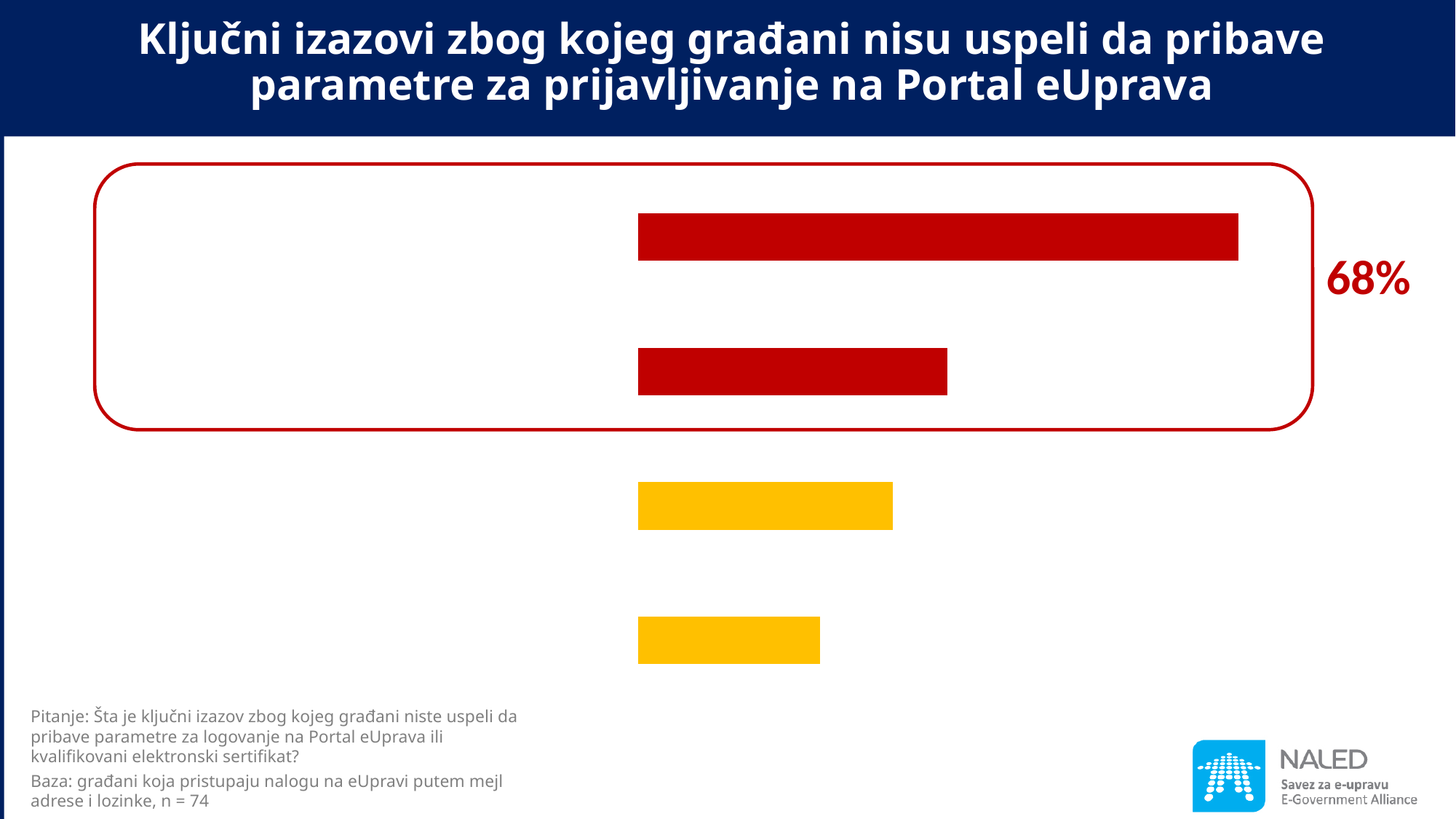
Which is longer, the second bar from the top or the third bar from the top? the second bar from the top How many bars are coloured red? 2 Which bar is the shortest: the top, second, third or bottom bar? the bottom bar How many bars does the chart contain? 4 What kind of chart is shown on the slide? bar chart Do the bar lengths increase or decrease from the top bar to the bottom bar? decrease What colour are the bottom two bars? yellow Which bar is the longest: the top, second, third or bottom bar? the top bar What is the sample size (n) stated in the base note at the bottom of the slide? 74 What percentage is printed next to the red box enclosing the top two bars? 68%